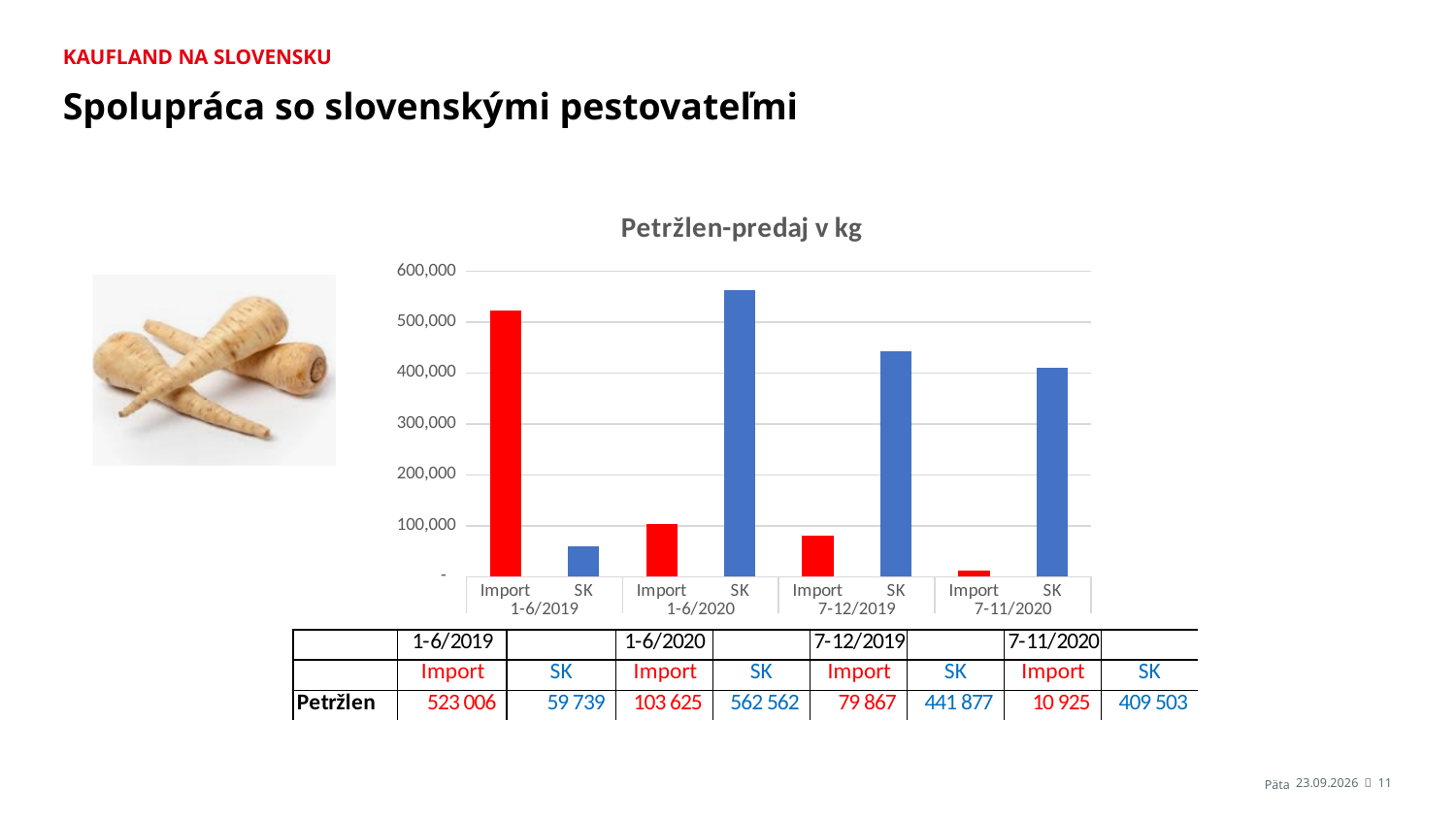
Which bar has the highest value in the chart? SK 1-6/2020 What is the SK value for 1-6/2020? 562 562 What is the SK value for 7-12/2019? 441 877 What is the Import value for 7-11/2020? 10 925 What is the difference between the SK value and the Import value for 1-6/2020? 458 937 Which bar has the lowest value in the chart? Import 7-11/2020 What is the Import value for 1-6/2019? 523 006 How many bars are plotted in the chart? 8 Which is larger for 7-12/2019, Import or SK? SK What kind of chart is shown on the slide? bar chart Is the SK value for 7-11/2020 greater or less than 400,000? greater What is the title of the chart? Petržlen-predaj v kg